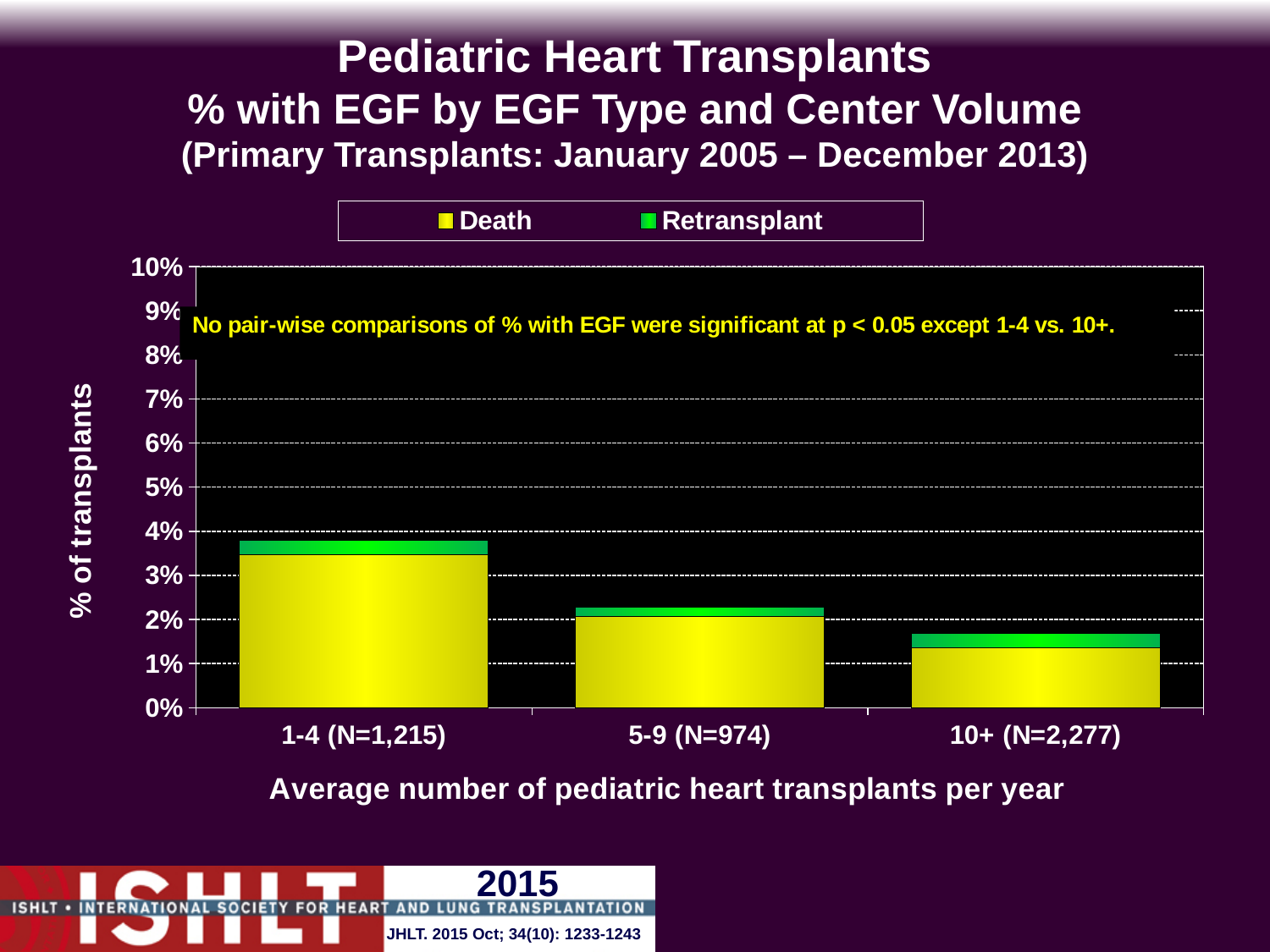
Which center-volume category has the lowest total % with EGF? 10+ (N=2,277) What kind of chart is shown on the slide? Stacked bar chart Is the total % with EGF for the 10+ (N=2,277) category greater or less than 2%? less Which center-volume category has the highest total % with EGF? 1-4 (N=1,215) Is the total % with EGF for the 5-9 (N=974) category greater or less than 3%? less Which series is shown in yellow in the legend? Death Is the total % with EGF for the 10+ (N=2,277) category greater or less than 1%? greater How many center-volume categories are shown on the x axis? 3 How many series does the legend list? 2 What is the title of the x axis? Average number of pediatric heart transplants per year Does the total % with EGF rise or fall as center volume increases from 1-4 to 10+? fall